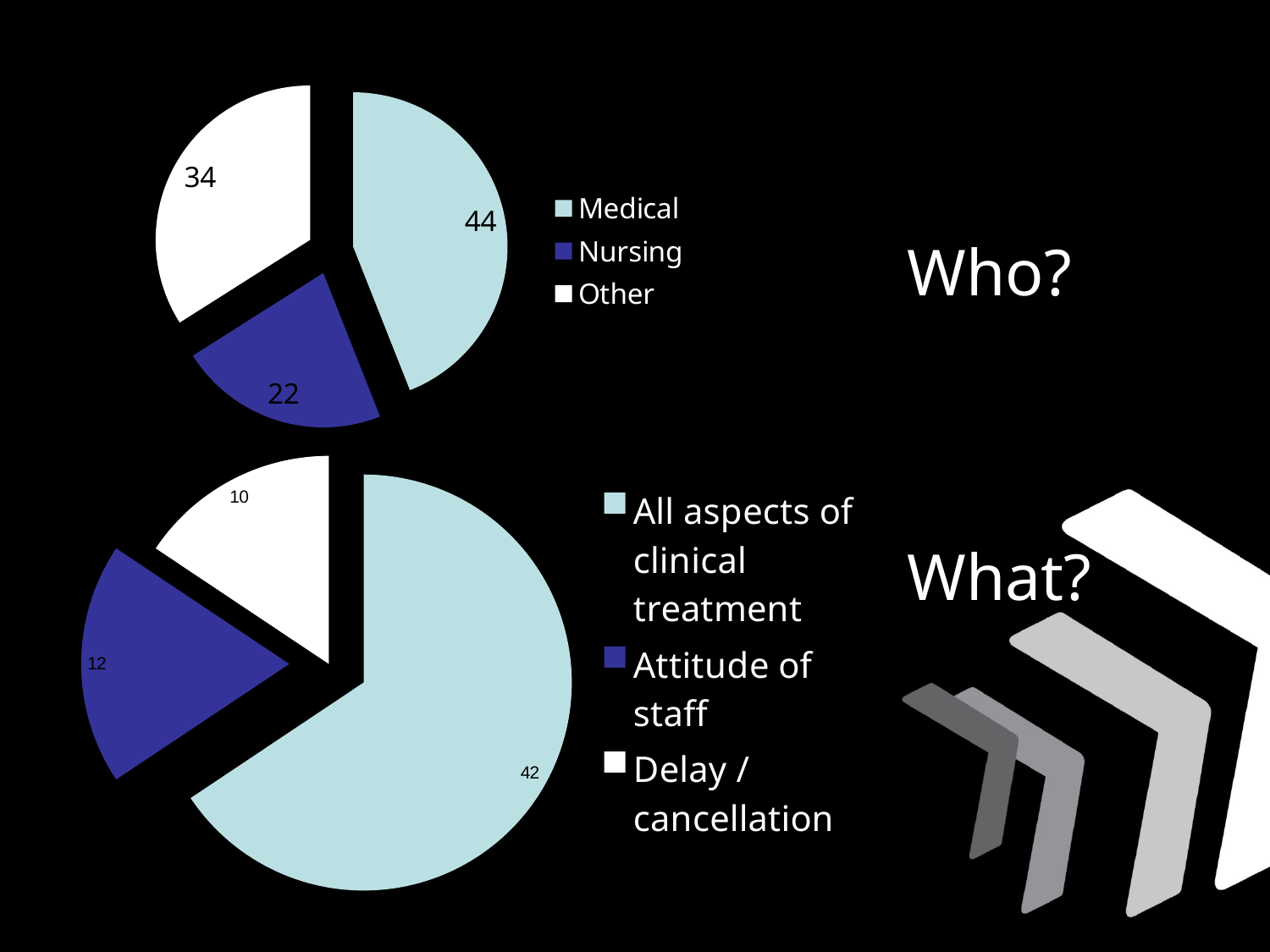
In the bottom pie chart (What?), which category has the largest slice? All aspects of clinical treatment In the top pie chart (Who?), what is the value for Medical? 44 What type of chart is the top chart (Who?)? Pie chart In the bottom pie chart (What?), what is the value for Delay / cancellation? 10 In the top pie chart (Who?), which category has the smallest slice? Nursing In the top pie chart (Who?), which category has the largest slice? Medical In the top pie chart (Who?), what share of the total does Medical represent? 44% In the bottom pie chart (What?), how many categories are shown? 3 In the top pie chart (Who?), what is the difference between the Medical and Other values? 10 In the top pie chart (Who?), what is the value for Nursing? 22 In the bottom pie chart (What?), what is the total of all three slices? 64 In the bottom pie chart (What?), what is the value for Attitude of staff? 12